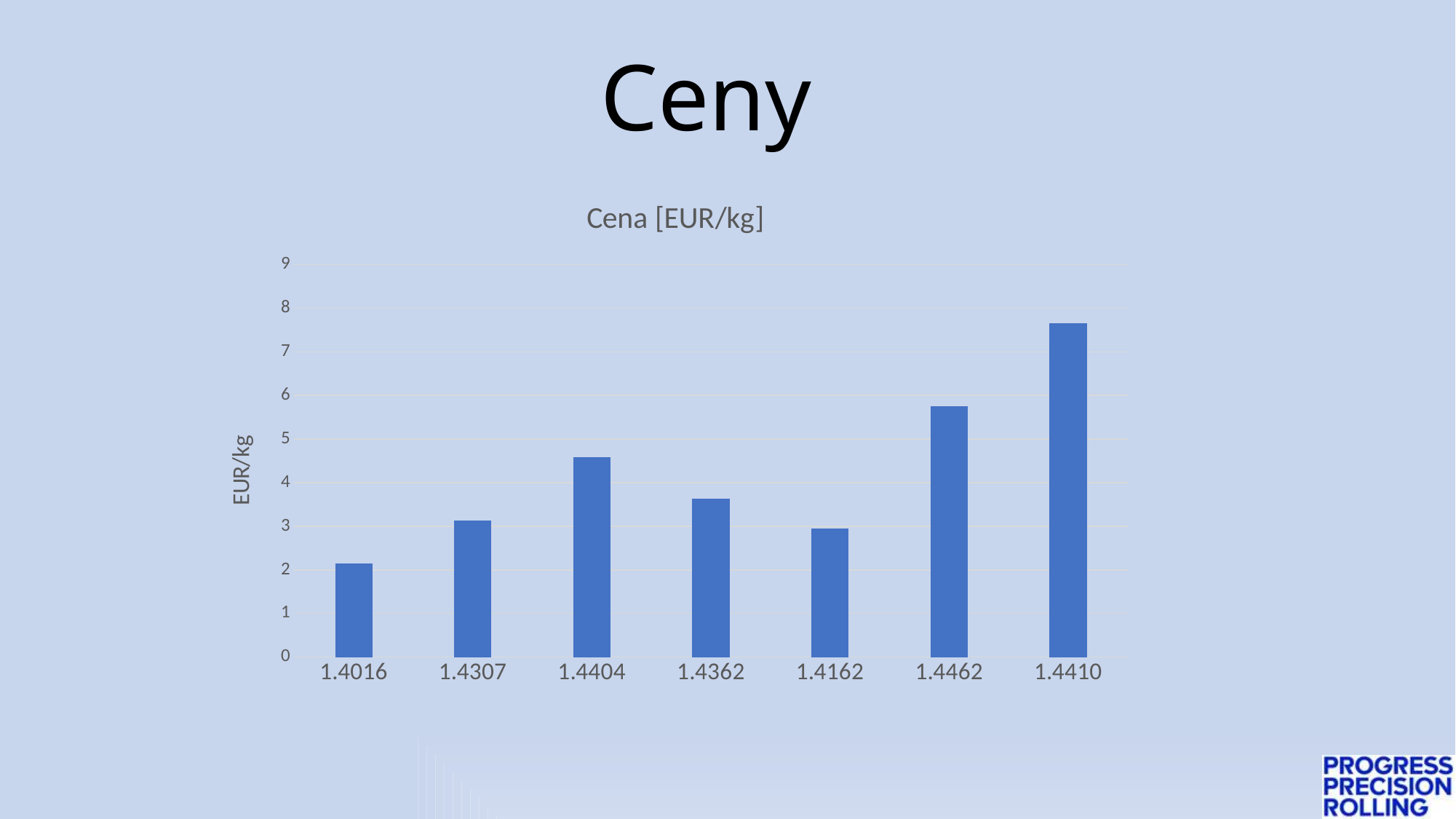
What is the label of the vertical axis? EUR/kg Which category has the lowest price? 1.4016 Is the value for 1.4410 greater or less than 7? greater Which category has the highest price? 1.4410 How many categories (bars) are shown in the chart? 7 What is the title of the chart? Cena [EUR/kg] Which has a higher price, 1.4404 or 1.4362? 1.4404 Is the value for 1.4462 greater or less than 6? less Is the value for 1.4404 greater or less than 4? greater Which has a higher price, 1.4162 or 1.4462? 1.4462 What kind of chart is shown on the slide? bar chart